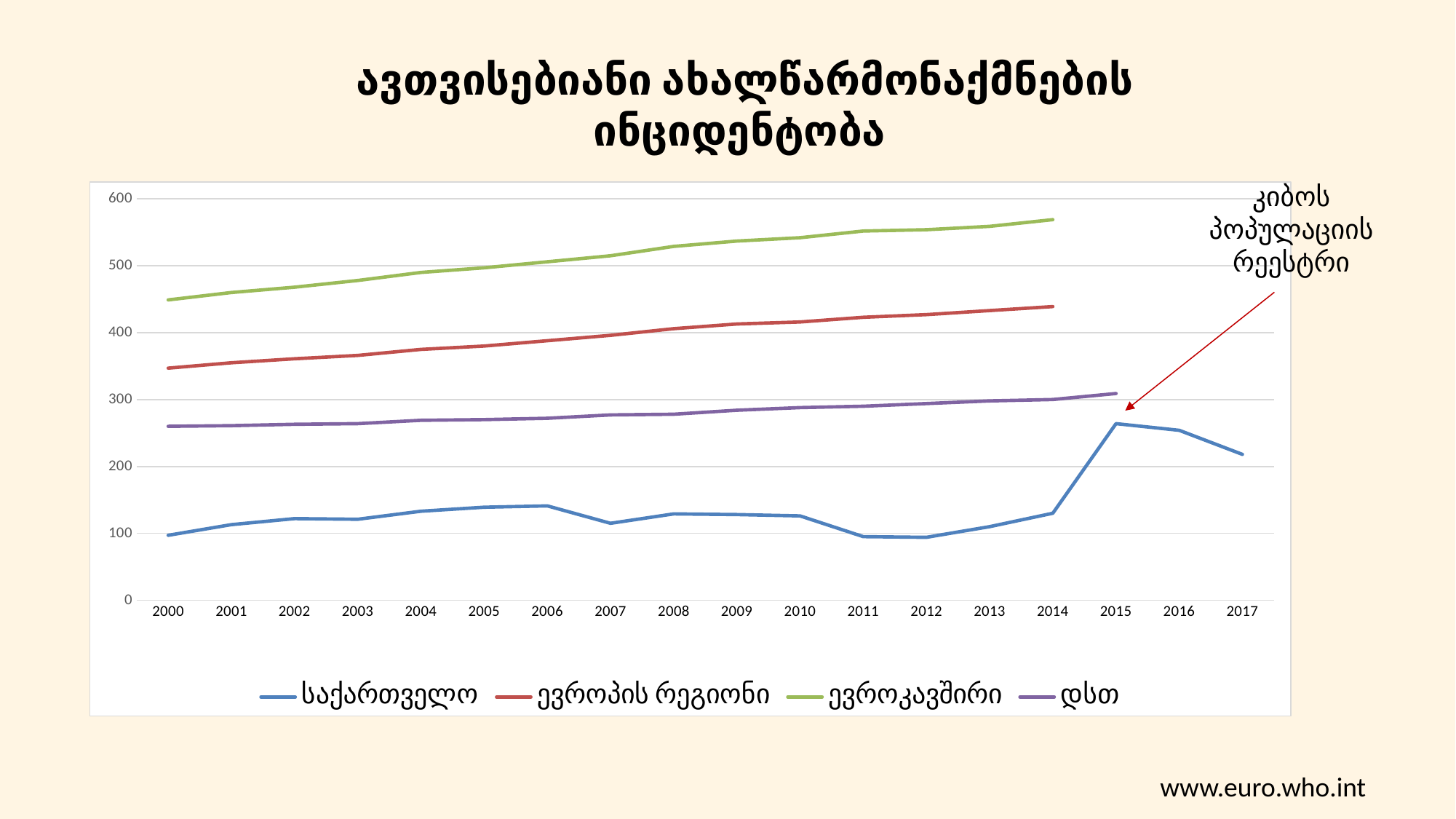
Is the value for ევროკავშირი in 2014 greater or less than 500? greater Is the value for დსთ in 2000 greater or less than 300? less Is the value for საქართველო in 2015 greater or less than 200? greater What kind of chart is shown on the slide? line chart What is the title of the chart? ავთვისებიანი ახალწარმონაქმნების ინციდენტობა Does the ევროკავშირი line rise or fall from 2000 to 2014? rise Which series has the lowest values throughout the chart? საქართველო How many series does the legend list? 4 Which series has the highest values throughout the chart? ევროკავშირი In 2010, which is larger: ევროკავშირი or ევროპის რეგიონი? ევროკავშირი How many years are shown along the x axis? 18